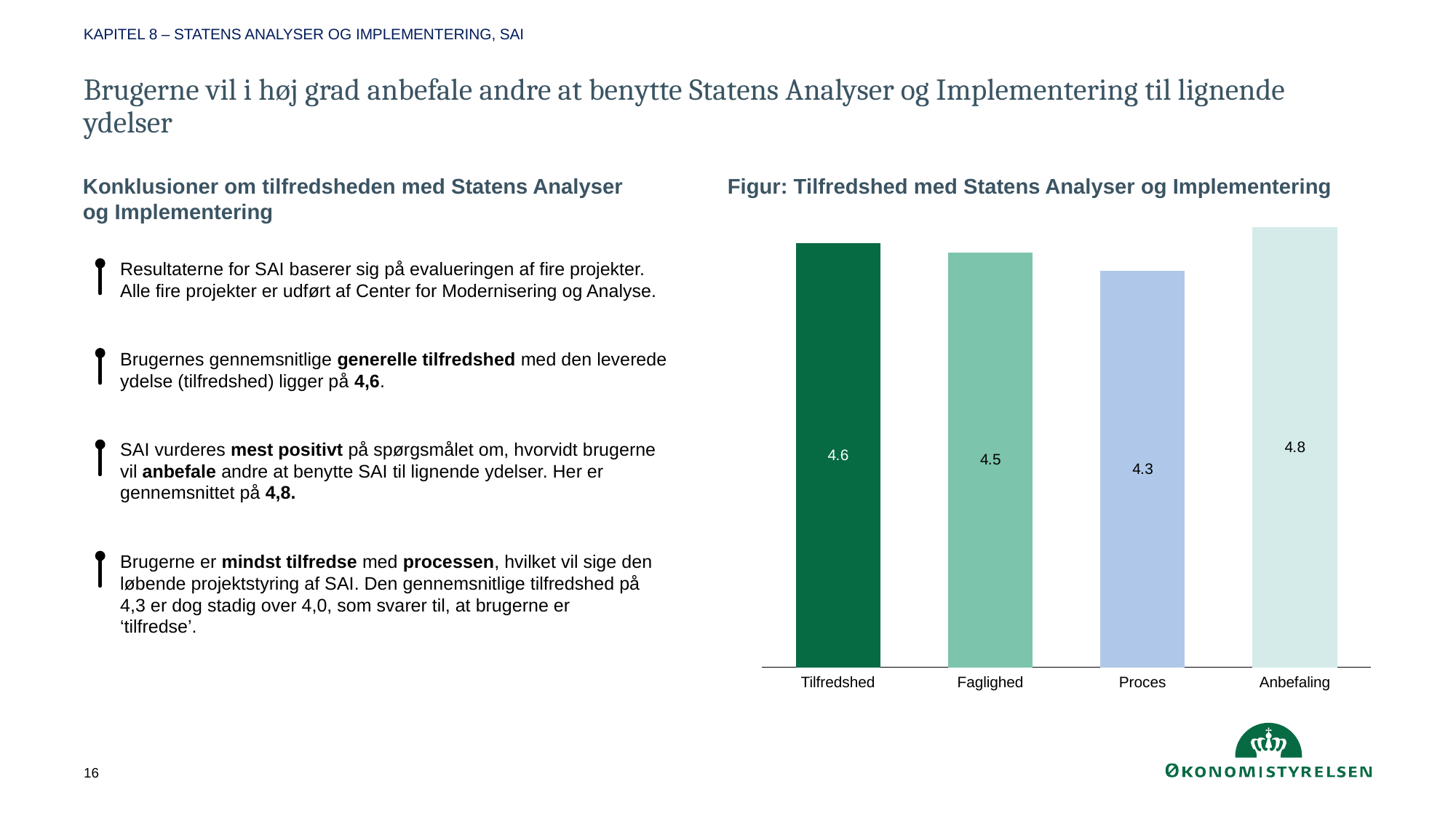
What is the difference between the values for Anbefaling and Proces? 0.5 What kind of chart is shown on the slide? Bar chart What is the value for Tilfredshed? 4.6 Which category has the lowest value? Proces Which is larger, the value for Tilfredshed or the value for Proces? Tilfredshed Which category has the highest value? Anbefaling How many categories are shown in the chart? 4 What is the value for Anbefaling? 4.8 What is the value for Faglighed? 4.5 What is the difference between the values for Tilfredshed and Faglighed? 0.1 What is the value for Proces? 4.3 What is the title of the chart? Figur: Tilfredshed med Statens Analyser og Implementering